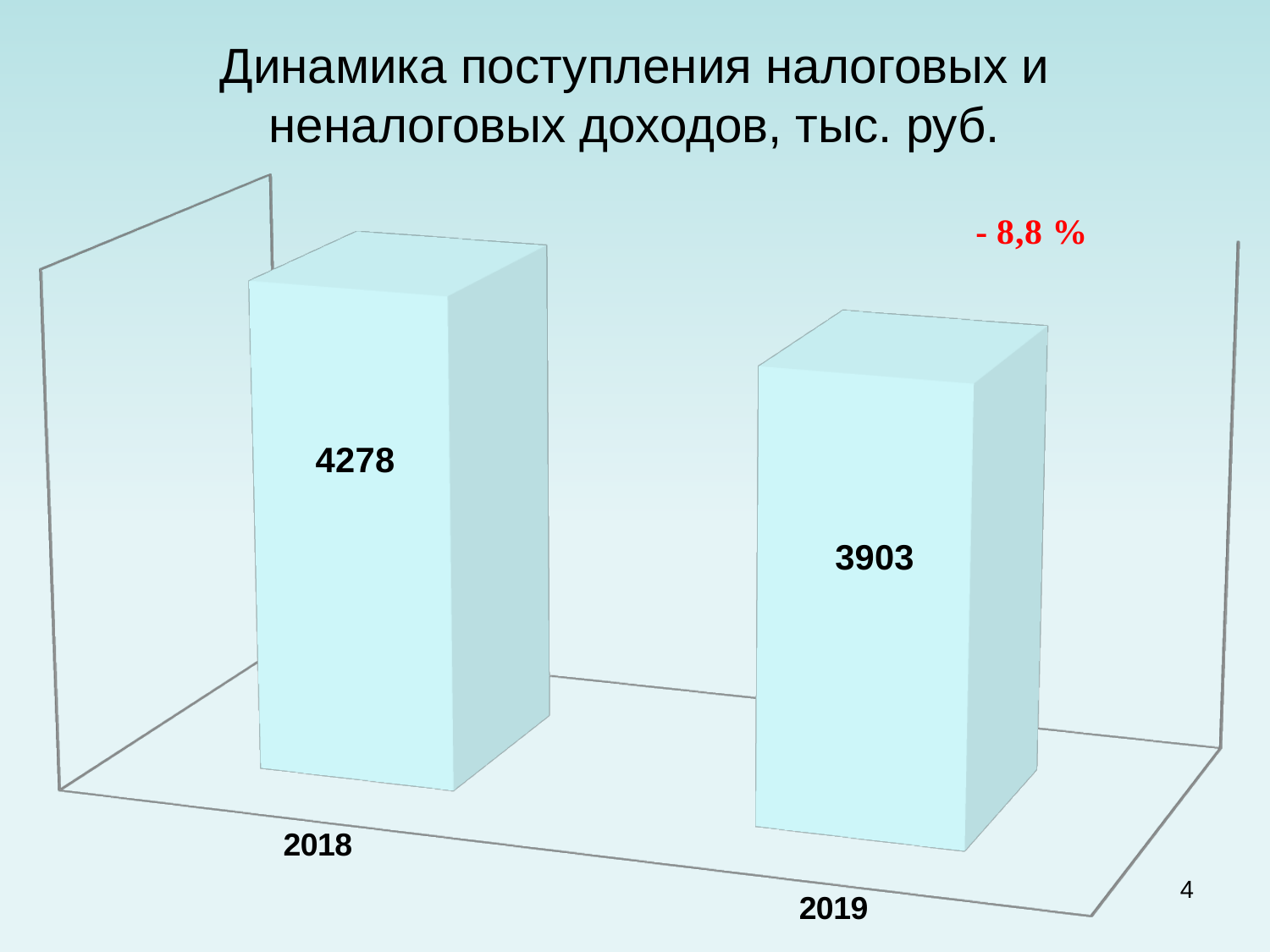
What is the value for 2018? 4278 What is the title of the chart? Динамика поступления налоговых и неналоговых доходов, тыс. руб. Which year has the highest value? 2018 What is the difference between the values for 2018 and 2019? 375 How many years are shown on the chart? 2 Which year has the lowest value? 2019 What percentage change is annotated in red on the chart? - 8,8 % What kind of chart is shown on the slide? bar chart Do the values rise or fall from 2018 to 2019? fall Which is larger, the value for 2018 or the value for 2019? 2018 What is the value for 2019? 3903